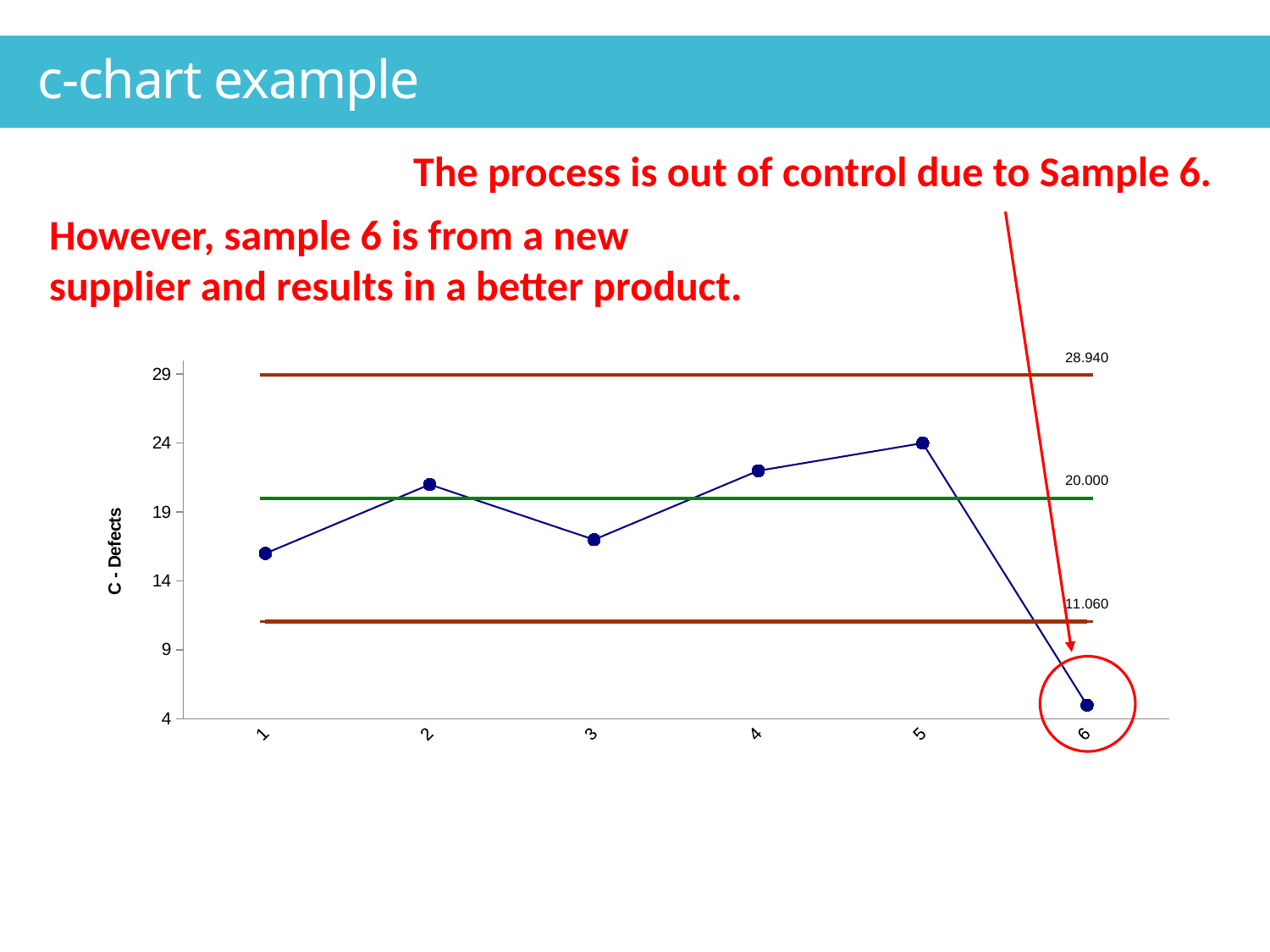
What is the label on the vertical axis? C - Defects Is the value for sample 1 greater or less than 19? less What kind of chart is shown on the slide? line chart Which has more defects, sample 4 or sample 3? sample 4 How many samples are plotted on the chart? 6 What value is printed for the lower control limit line? 11.060 Which sample has the highest number of defects? 5 What value is printed for the upper control limit line? 28.940 Which sample has the lowest number of defects? 6 Is the value for sample 6 greater or less than 9? less Is the value for sample 3 greater or less than 19? less